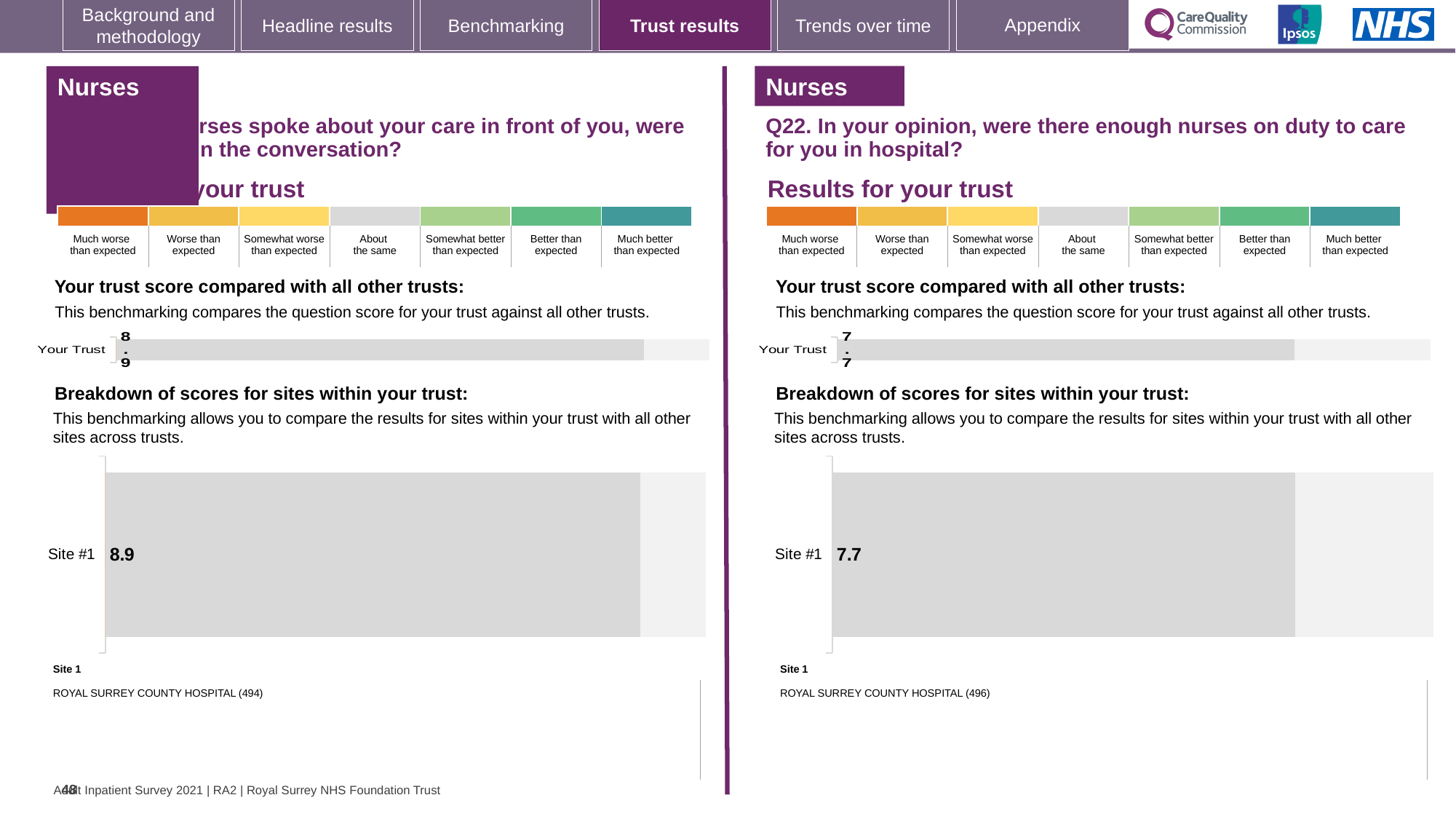
Which is larger: the Your Trust score on the left-hand chart or the Your Trust score on the right-hand (Q22) chart? Left-hand chart (8.9) Which site is listed as Site 1 under the breakdown chart on the left-hand side? ROYAL SURREY COUNTY HOSPITAL (494) In the Q22 'Breakdown of scores for sites within your trust' chart on the right, what is the score for Site #1? 7.7 On the left-hand side of the slide, what is the score shown for Your Trust? 8.9 What type of chart is used to show the Site #1 score on the left-hand side? Bar chart In the 'Breakdown of scores for sites within your trust' chart on the left, what is the score for Site #1? 8.9 Is the Your Trust score on the right-hand (Q22) chart greater or less than 8? less On the right-hand side (Q22), what is the score shown for Your Trust? 7.7 How many sites are shown in the Q22 site breakdown chart on the right? 1 Which site is listed as Site 1 under the Q22 breakdown chart on the right? ROYAL SURREY COUNTY HOSPITAL (496) What is the difference between the Site #1 score on the left-hand chart and the Site #1 score on the right-hand (Q22) chart? 1.2